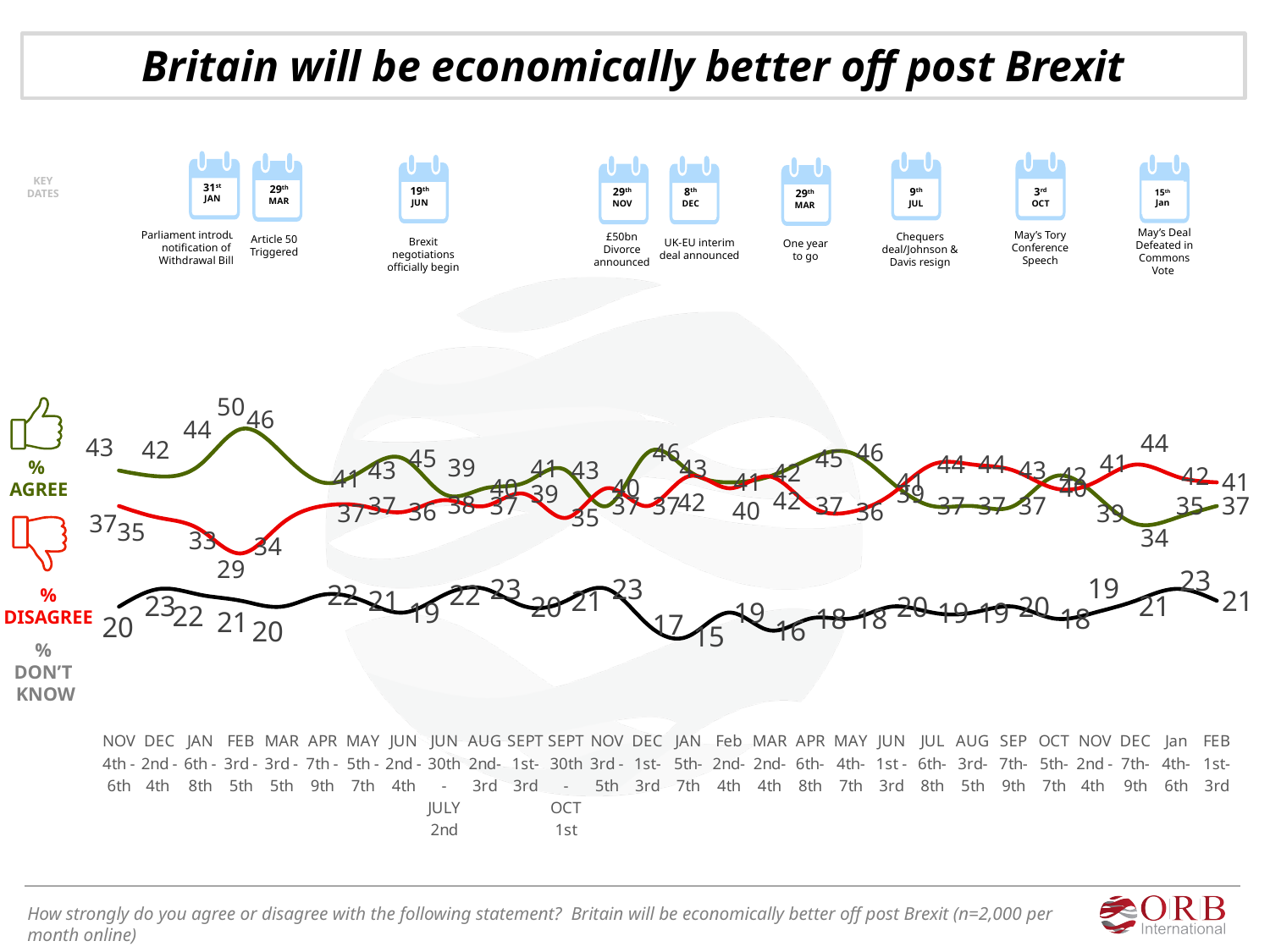
What is the % Disagree value for the FEB 3rd-5th survey period? 29 How many survey periods are shown along the x axis? 28 In the final survey period, FEB 1st-3rd, which is larger: % Agree or % Disagree? % Disagree What is the difference between % Agree and % Disagree in the FEB 3rd-5th survey period? 21 In which survey period does the % Agree line reach its highest value? FEB 3rd-5th What is the title of the chart? Britain will be economically better off post Brexit What is the % Agree value for the first survey period, NOV 4th-6th? 43 What is the % Disagree value for the last survey period, FEB 1st-3rd? 41 What is the lowest value shown on the % Agree line? 34 How many series are plotted on the chart? 3 What kind of chart is shown on the slide? Line chart What is the % Don't Know value for the JAN 5th-7th survey period? 15